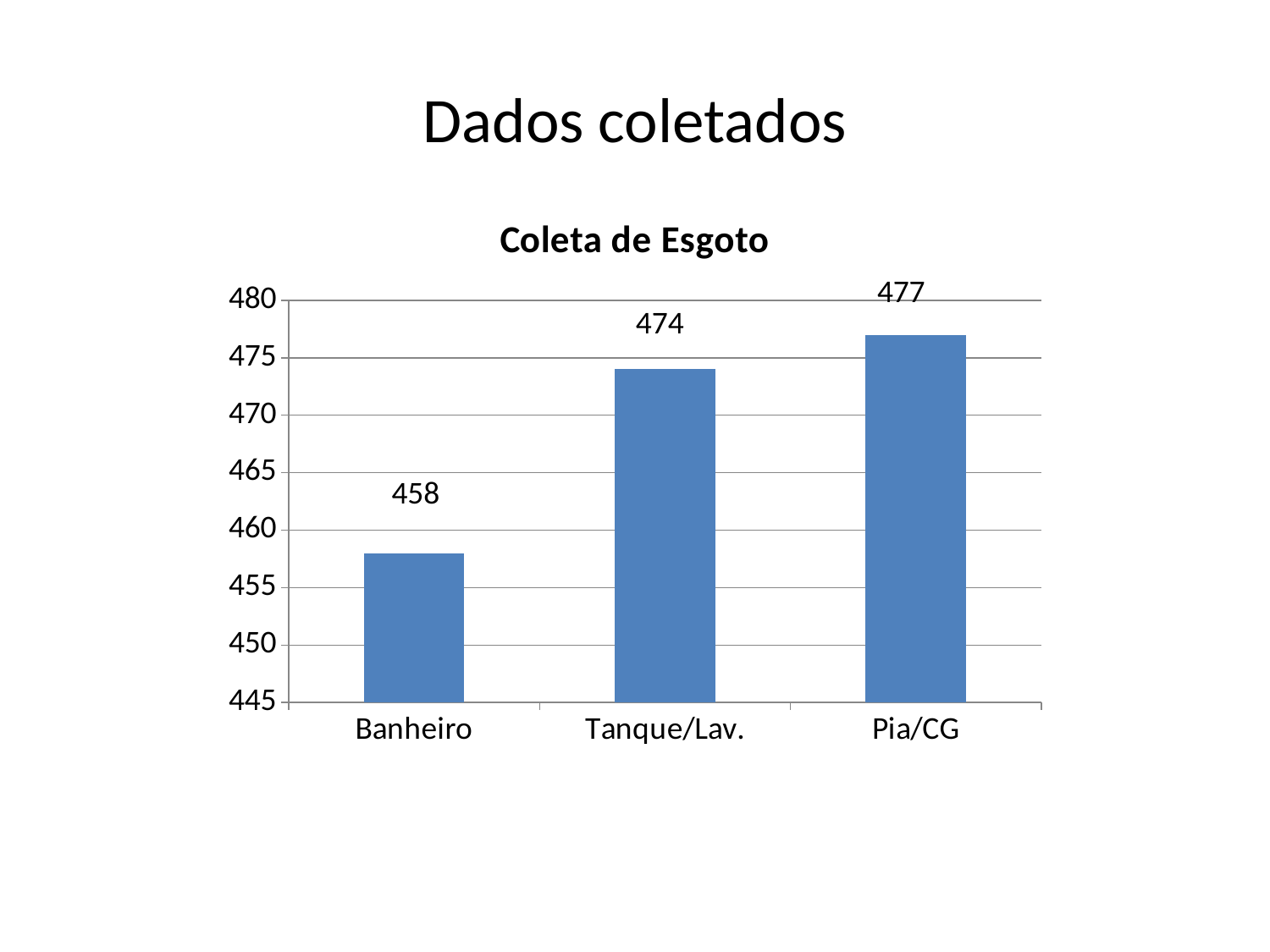
Is the value for Banheiro greater or less than 460? less Which category has the highest value? Pia/CG What is the difference between the values for Tanque/Lav. and Banheiro? 16 What is the value for Tanque/Lav.? 474 What is the value for Pia/CG? 477 What is the title of the chart? Coleta de Esgoto How many categories are shown in the chart? 3 What kind of chart is shown on the slide? bar chart Which category has the lowest value? Banheiro What is the difference between the values for Pia/CG and Banheiro? 19 Which is larger, the value for Tanque/Lav. or the value for Banheiro? Tanque/Lav. What is the value for Banheiro? 458